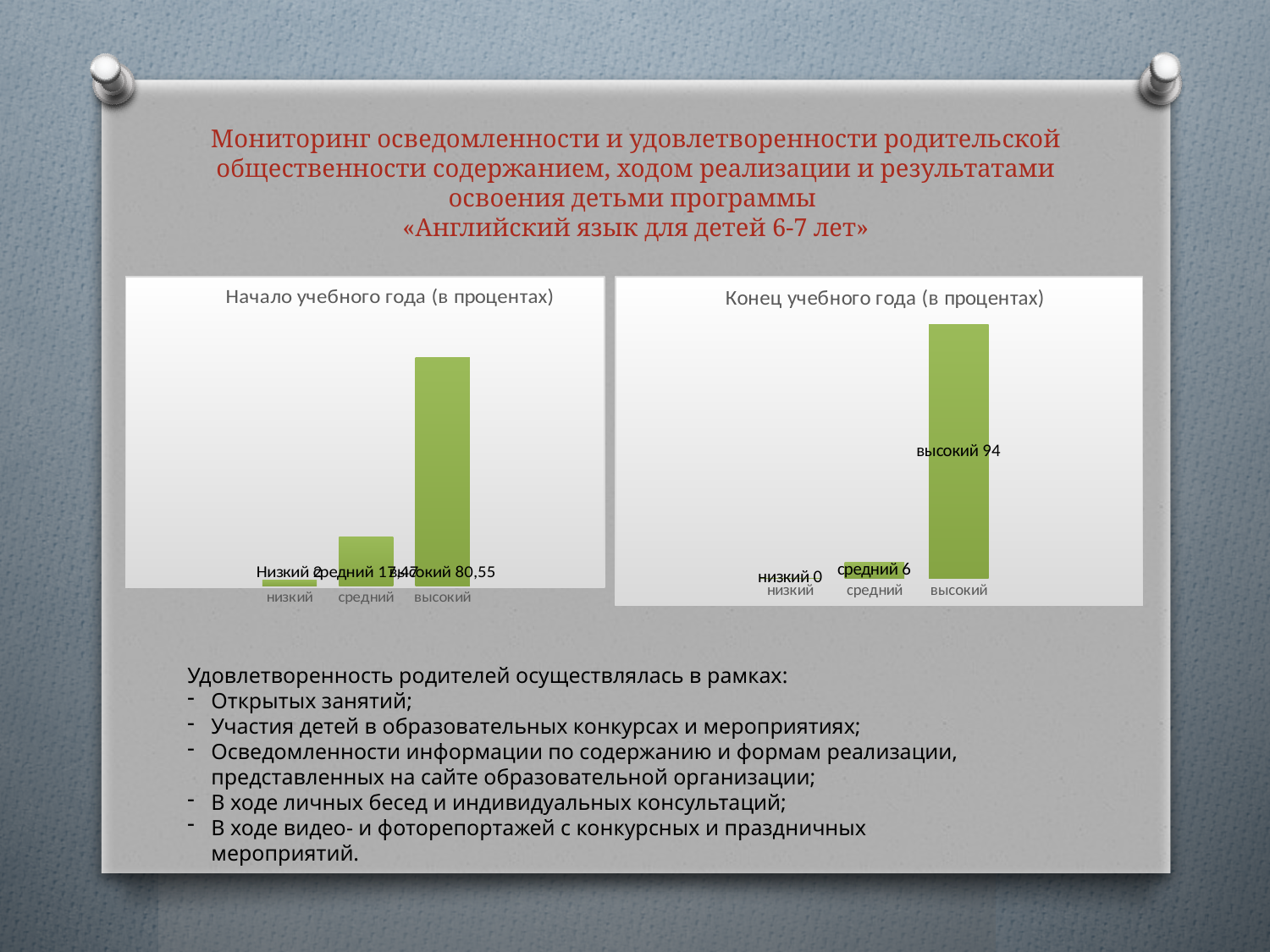
In the right-hand chart (Конец учебного года), what is the value for средний? 6 In the left-hand chart (Начало учебного года), which category has the highest value? высокий In the right-hand chart (Конец учебного года), what is the value for низкий? 0 In the left-hand chart (Начало учебного года), what is the value for высокий? 80,55 In the right-hand chart (Конец учебного года), what is the difference between the values for высокий and средний? 88 What kind of chart is the right-hand chart (Конец учебного года)? bar chart In the right-hand chart (Конец учебного года), do the values rise or fall from низкий to высокий along the x axis? rise Is the value for высокий larger in the left-hand chart (Начало учебного года) or in the right-hand chart (Конец учебного года)? Конец учебного года In the chart titled «Конец учебного года (в проценtах)», what is the value for высокий? 94 In the left-hand chart (Начало учебного года), what is the value for низкий? 2 How many categories are shown in the left-hand chart (Начало учебного года)? 3 In the right-hand chart (Конец учебного года), which category has the lowest value? низкий